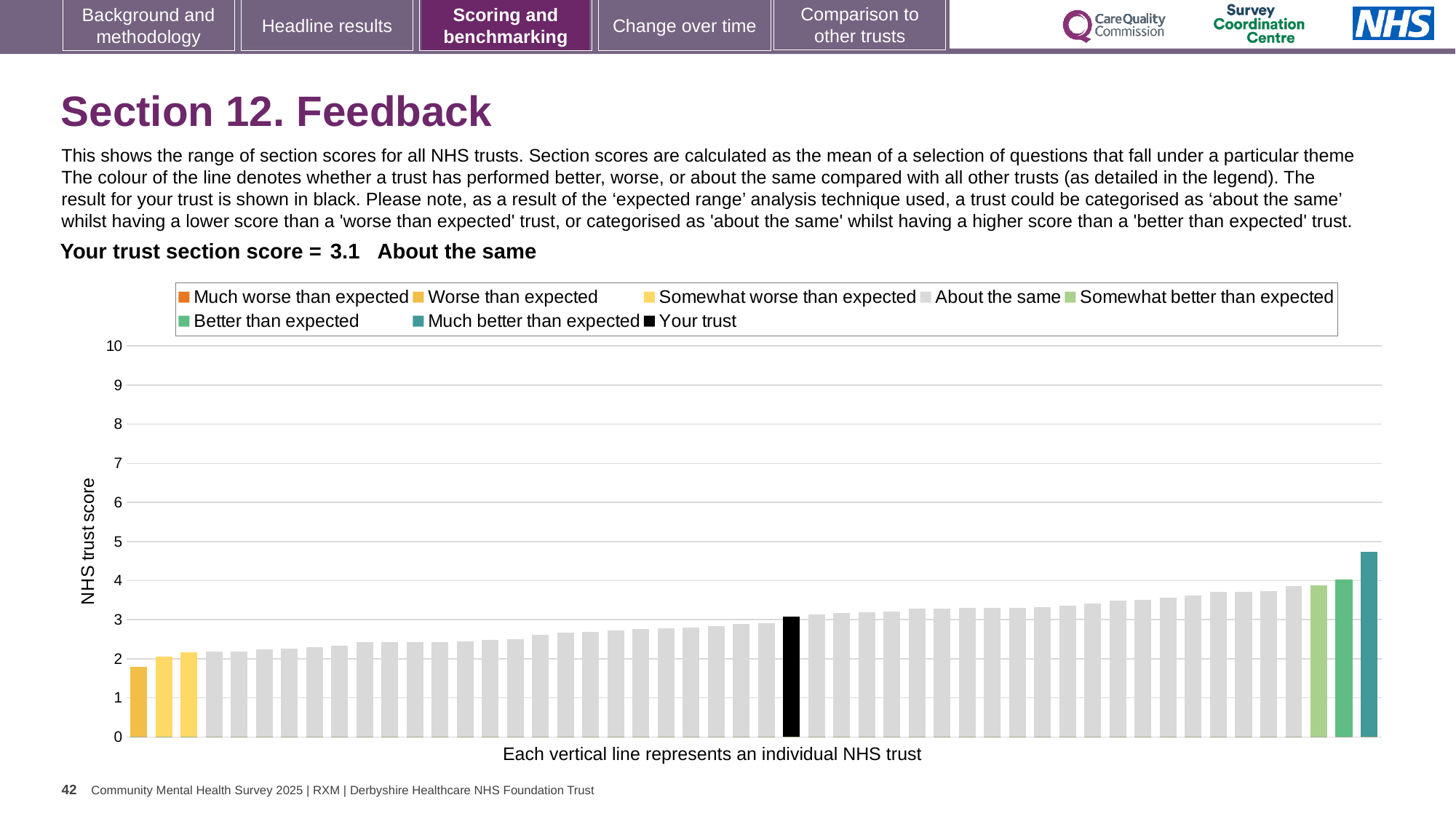
What is the section score for your trust? 3.1 Do the trust scores rise or fall from left to right along the x axis? rise What kind of chart is shown on the slide? bar chart Is the value for the highest-scoring trust greater or less than 5? less Is the value for the highest-scoring trust greater or less than 4? greater How many entries does the chart legend list? 8 Which category is your trust placed in for this section? About the same Which legend category does the highest bar belong to? Much better than expected Which legend category does the lowest bar belong to? Worse than expected What is the label on the vertical axis? NHS trust score Is the value for your trust greater or less than 3? greater